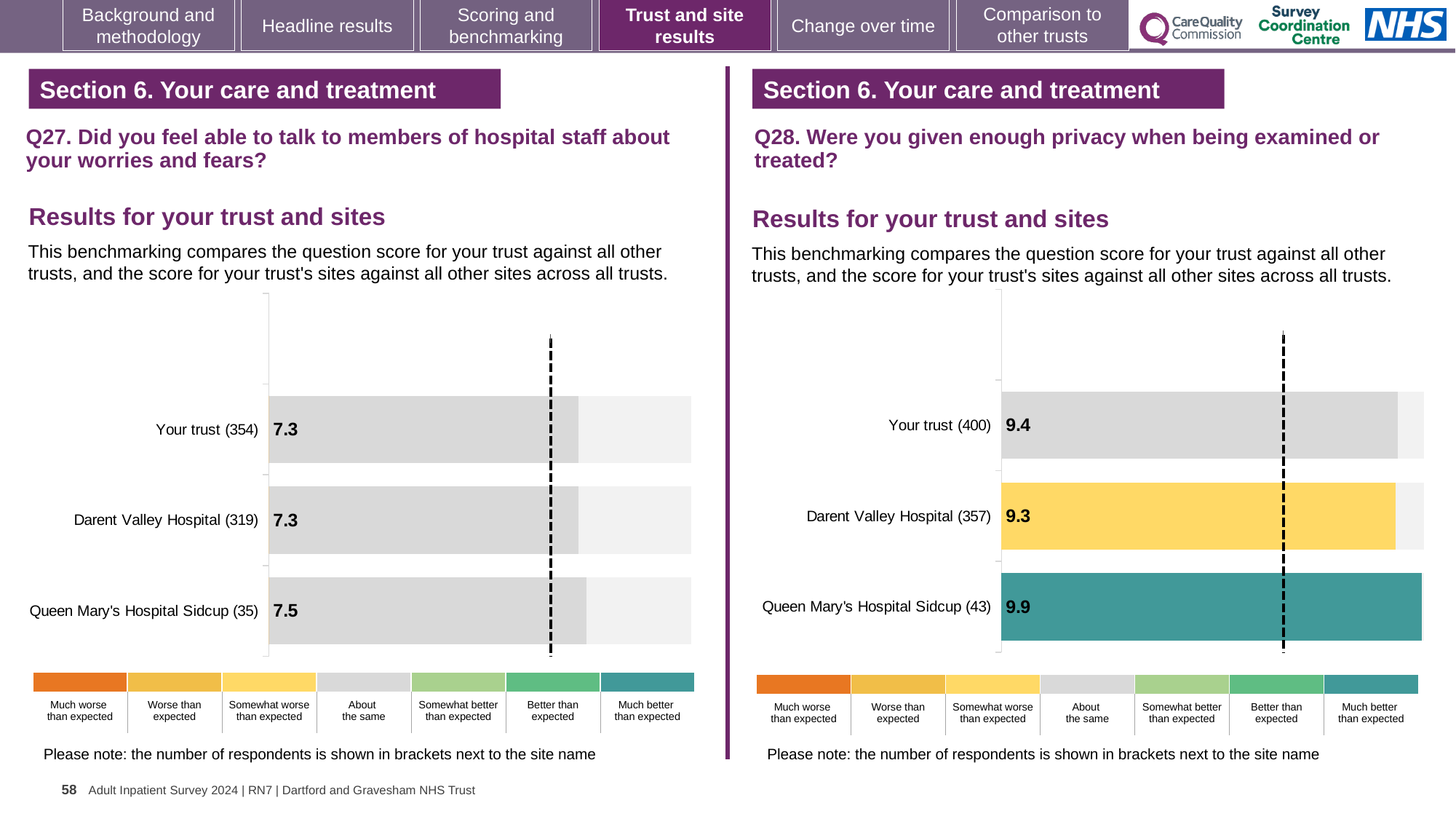
In the Q28 chart on the right, what is the score for Queen Mary's Hospital Sidcup (43)? 9.9 In the Q28 chart on the right, what is the difference between the scores for Queen Mary's Hospital Sidcup (43) and Darent Valley Hospital (357)? 0.6 What kind of chart is used for the Q28 results on the right? bar chart In the Q27 chart on the left, what is the difference between the scores for Queen Mary's Hospital Sidcup (35) and Your trust (354)? 0.2 How many bars are plotted in the Q27 chart on the left? 3 In the Q28 chart on the right, what is the score for Darent Valley Hospital (357)? 9.3 In the Q27 chart on the left, what is the score for Queen Mary's Hospital Sidcup (35)? 7.5 In the Q28 chart on the right, is the score for Your trust (400) larger or smaller than the score for Darent Valley Hospital (357)? larger In the Q28 chart on the right, which site or trust has the lowest score? Darent Valley Hospital (357) In the Q27 chart on the left, what is the score for Your trust (354)? 7.3 In the Q28 chart on the right, which site or trust has the highest score? Queen Mary's Hospital Sidcup (43) In the Q27 chart on the left, which site or trust has the highest score? Queen Mary's Hospital Sidcup (35)